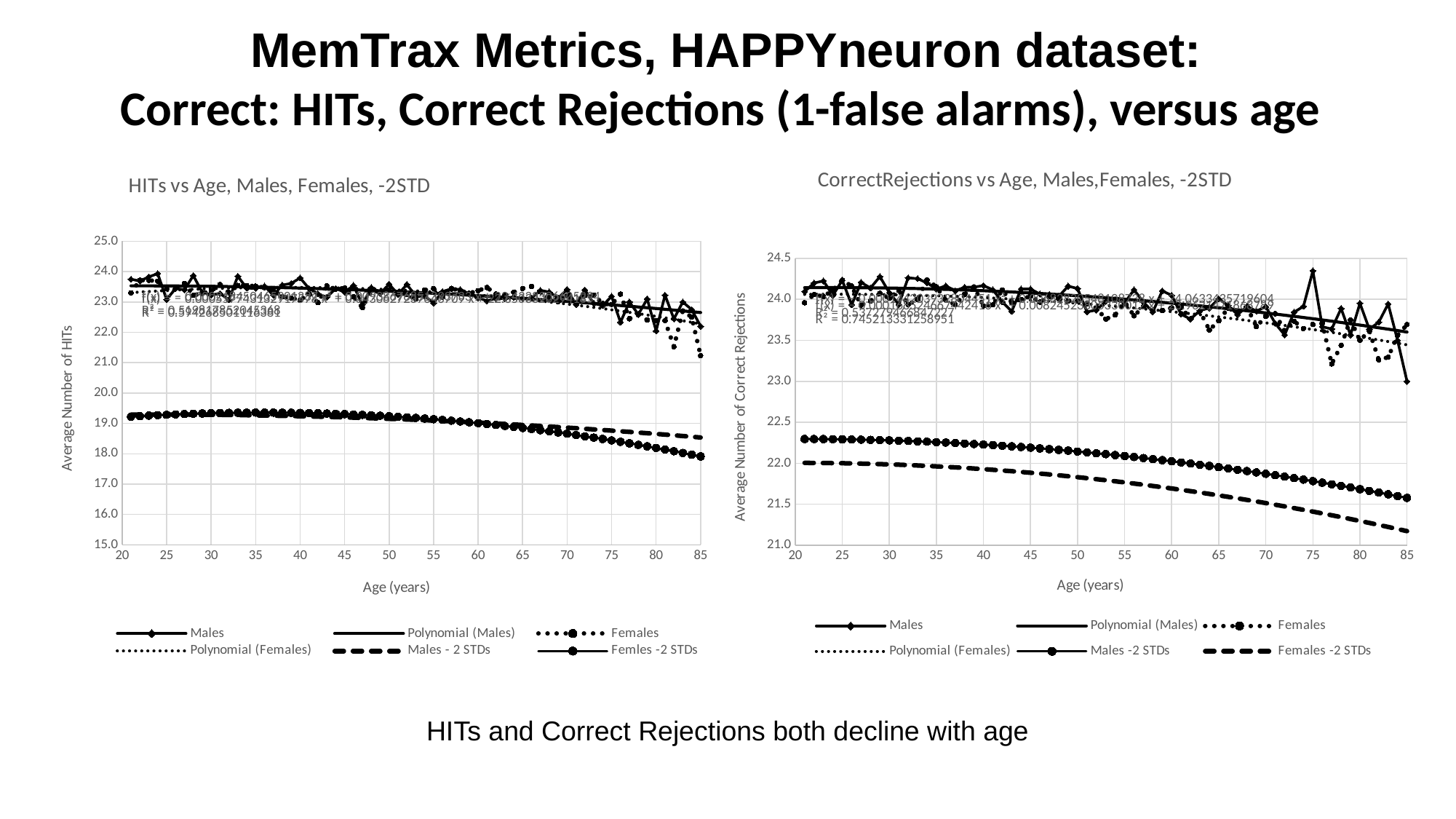
In the left chart, 'HITs vs Age, Males, Females, -2STD', does the 'Femles -2 STDs' series rise or fall overall as age increases from 20 to 85? fall In the left chart, 'HITs vs Age, Males, Females, -2STD', is the 'Males - 2 STDs' value at age 85 greater or less than 18.0? greater In the left chart, 'HITs vs Age, Males, Females, -2STD', is the 'Females' value at age 85 greater or less than 22.0? less What kind of chart is the right chart, 'CorrectRejections vs Age, Males,Females, -2STD'? line chart In the right chart, 'CorrectRejections vs Age, Males,Females, -2STD', is the 'Males' value at age 75 greater or less than 24.0? greater How many series does the legend of the right chart, 'CorrectRejections vs Age, Males,Females, -2STD', list? 6 What kind of chart is the left chart, 'HITs vs Age, Males, Females, -2STD'? line chart What is the x-axis label on the right chart, 'CorrectRejections vs Age, Males,Females, -2STD'? Age (years) In the left chart, 'HITs vs Age, Males, Females, -2STD', at age 85 which is higher: 'Males - 2 STDs' or 'Femles -2 STDs'? Males - 2 STDs How many series does the legend of the left chart, 'HITs vs Age, Males, Females, -2STD', list? 6 In the right chart, 'CorrectRejections vs Age, Males,Females, -2STD', does the 'Females -2 STDs' series rise or fall as age increases? fall